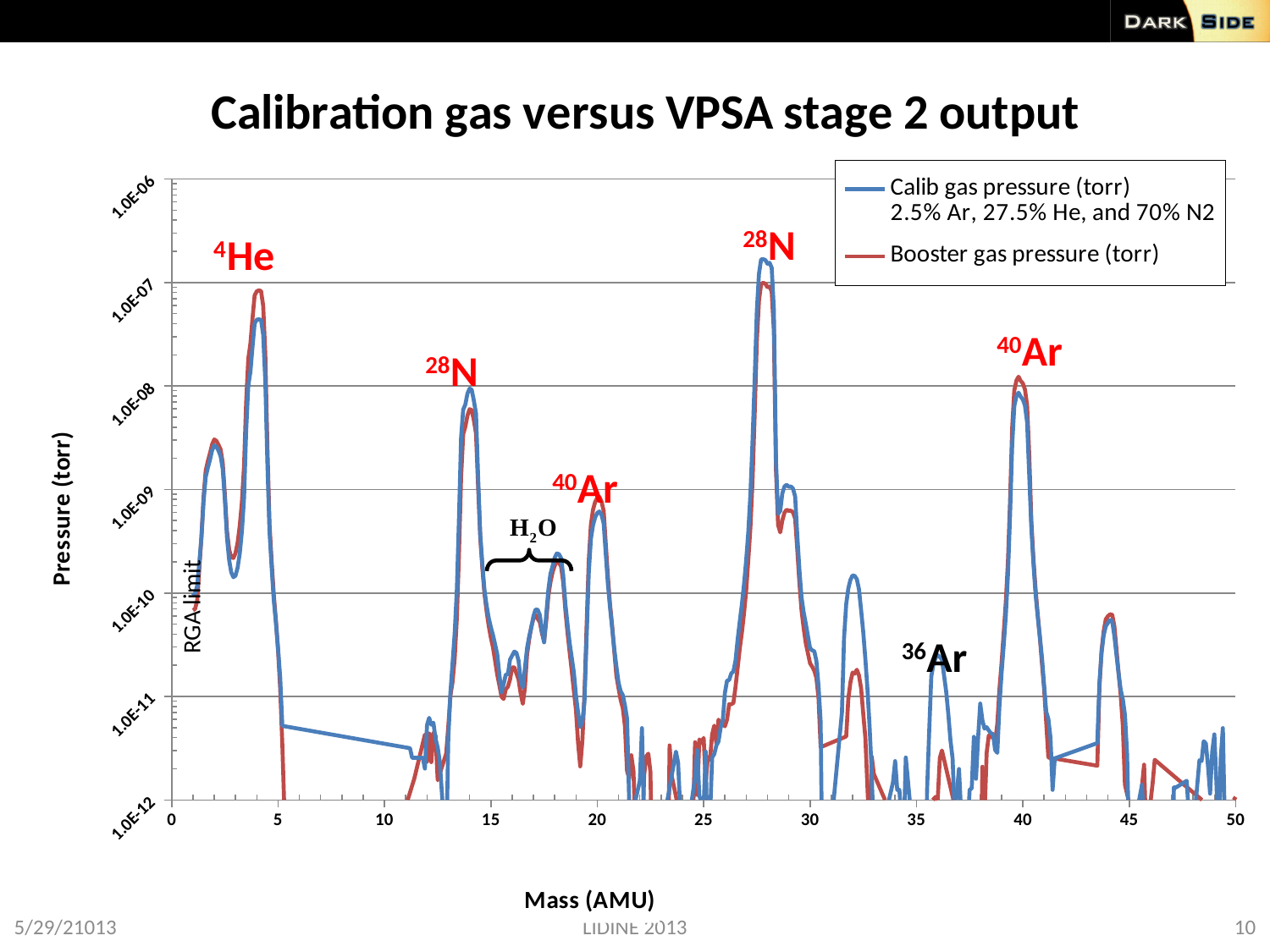
Which labeled peak reaches the highest pressure on the chart? 28N (near mass 28 AMU) Is the Calib gas pressure at the 28N peak near mass 28 AMU greater or less than 1.0E-07 torr? greater How many series does the legend list? 2 What is the label of the x axis? Mass (AMU) What is the title of the chart? Calibration gas versus VPSA stage 2 output Is the Booster gas pressure at the 40Ar peak near mass 40 AMU greater or less than 1.0E-09 torr? greater What is the highest value shown on the x axis (Mass)? 50 Is the Calib gas pressure at the 4He peak near mass 4 AMU greater or less than 1.0E-07 torr? less Which series is higher at the 28N peak near mass 28 AMU, Calib gas pressure or Booster gas pressure? Calib gas pressure (torr) Which series is higher at the 4He peak near mass 4 AMU, Calib gas pressure or Booster gas pressure? Booster gas pressure (torr) What kind of chart is shown on the slide? line chart Which series is higher at the 28N peak near mass 14 AMU, Calib gas pressure or Booster gas pressure? Calib gas pressure (torr)